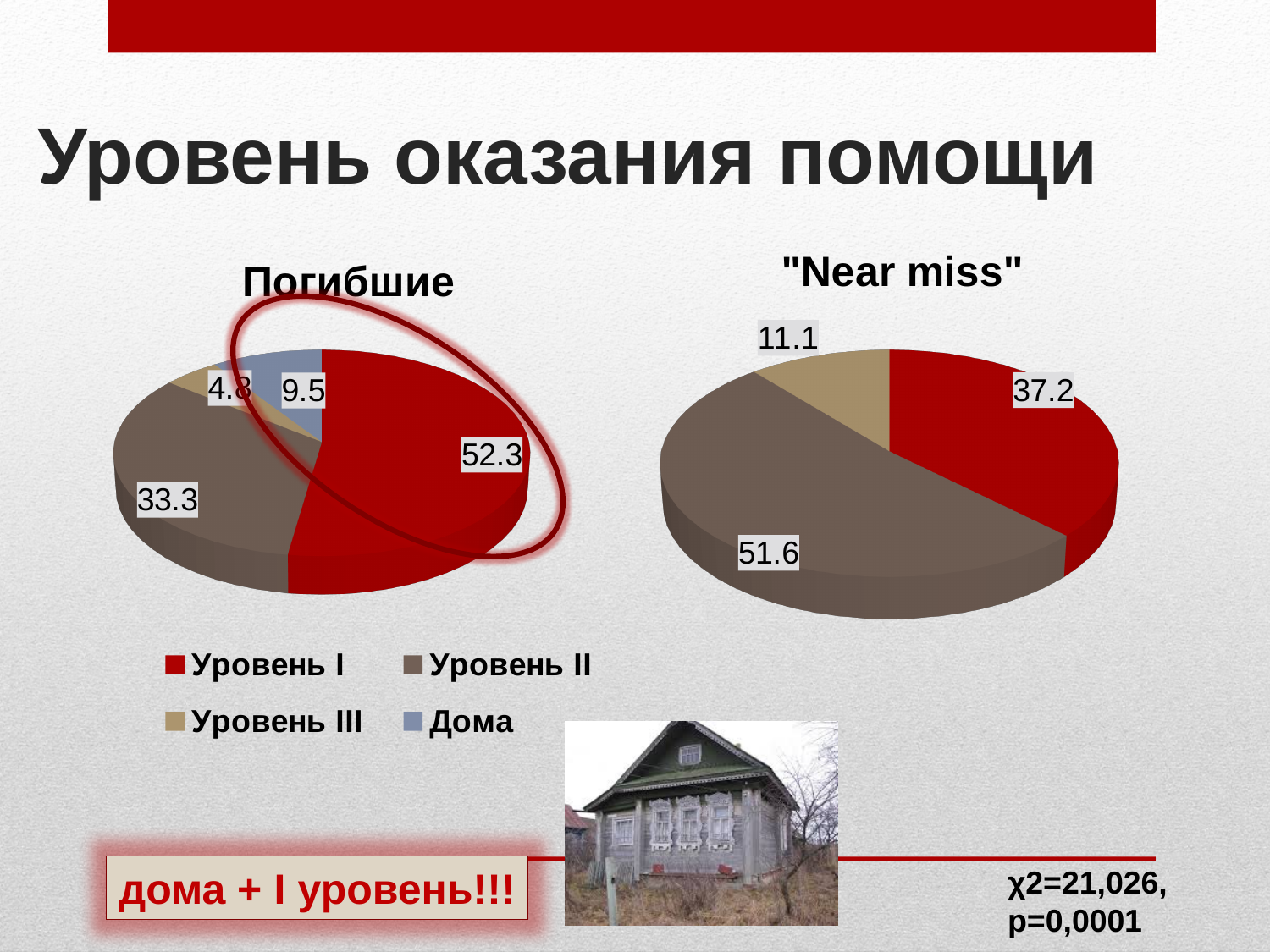
In the "Погибшие" chart, which is larger: the value for Уровень II or the value for Дома? Уровень II How many entries does the legend list? 4 In the "Погибшие" chart, which category has the largest slice? Уровень I In the "Погибшие" chart, which category has the smallest slice? Уровень III In the "Погибшие" chart, what is the value for Дома? 9.5 How many slices does the "Near miss" chart have? 3 In the "Погибшие" chart, what is the value for Уровень I? 52.3 What kind of chart is the "Погибшие" chart? Pie chart In the "Near miss" chart, what is the value for Уровень II? 51.6 In the "Near miss" chart, which category has the largest slice? Уровень II In the "Near miss" chart, what is the value for Уровень III? 11.1 In the "Near miss" chart, what is the difference between the values for Уровень II and Уровень I? 14.4